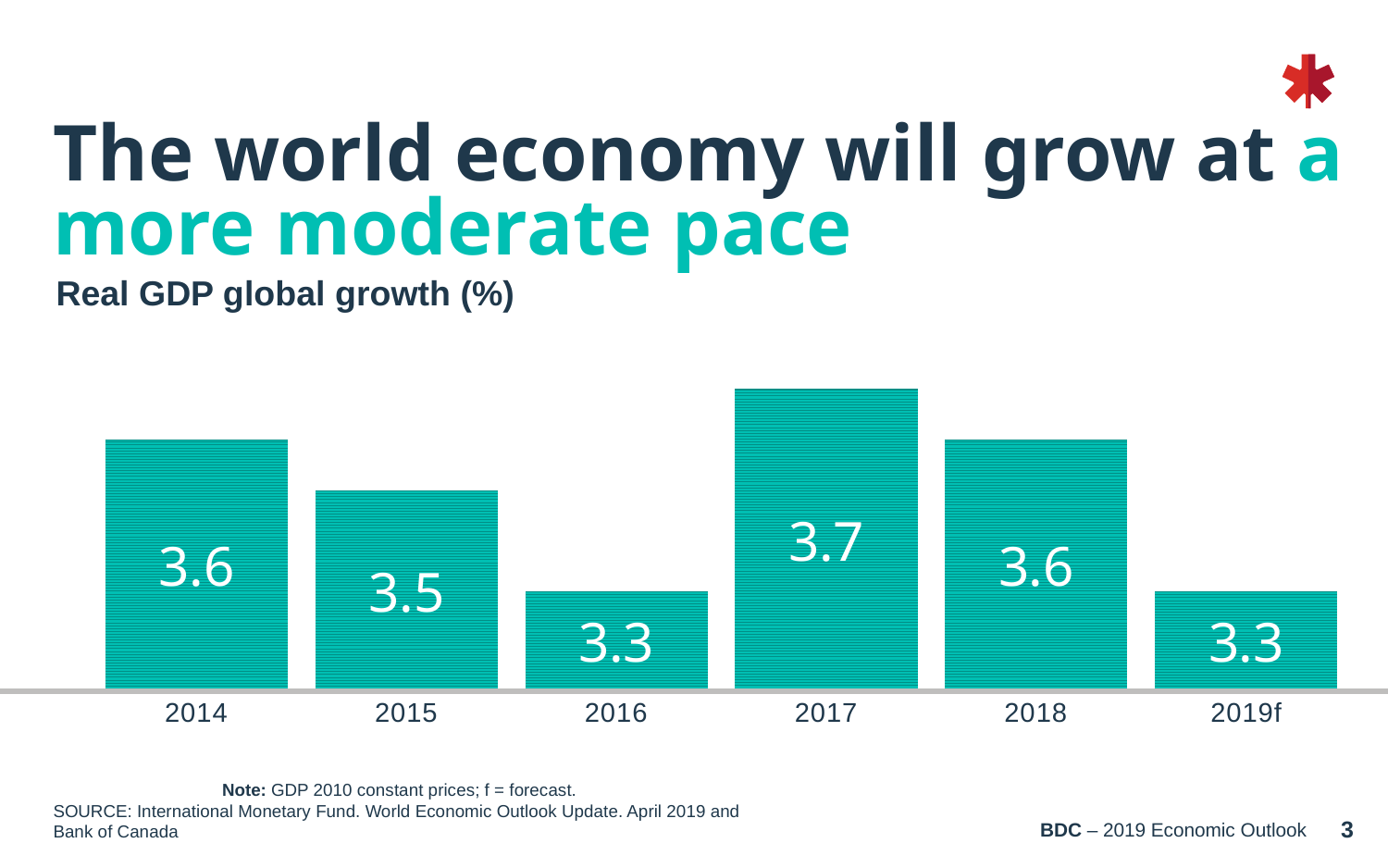
What is the real GDP global growth value for 2019f? 3.3 What is the difference between the 2018 value and the 2019f value? 0.3 How many years are shown on the chart? 6 Which year has the highest real GDP global growth? 2017 What is the real GDP global growth value for 2015? 3.5 What kind of chart is shown on the slide? Bar chart Which is larger, the value for 2014 or the value for 2015? 2014 What is the difference between the 2017 value and the 2016 value? 0.4 Do the values rise or fall from 2017 to 2019f? Fall Which is larger, the value for 2015 or the value for 2016? 2015 What is the chart's subtitle describing the plotted measure? Real GDP global growth (%) What is the real GDP global growth value for 2017? 3.7